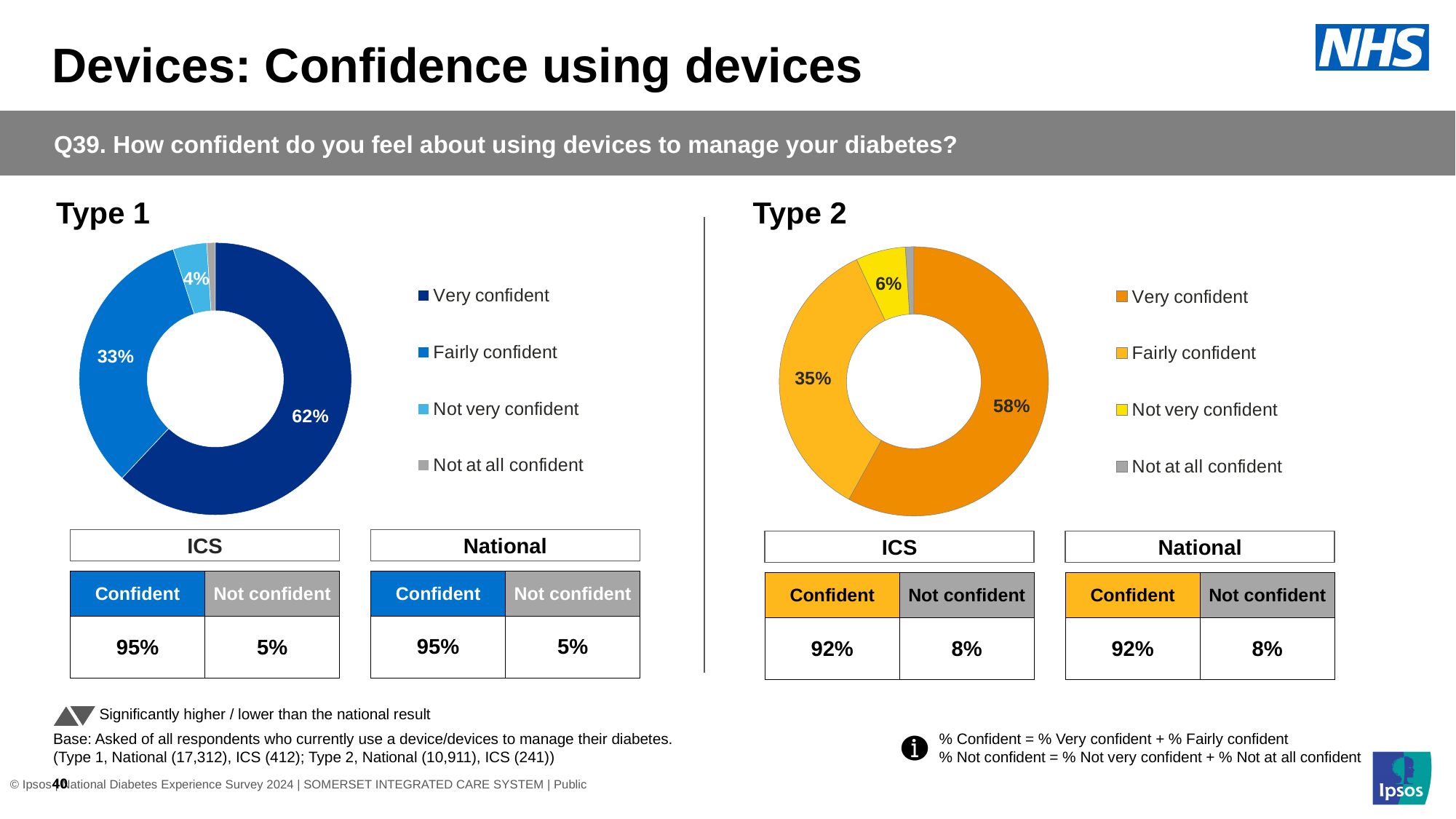
In the Type 1 chart, what percentage are fairly confident? 33% In the Type 2 chart, what percentage are not very confident? 6% In the Type 1 chart, which category has the largest share? Very confident How many categories does the legend of the Type 1 chart list? 4 In the Type 2 chart, which category has the smallest share? Not at all confident In the Type 2 chart, what is the combined share of very confident and fairly confident? 93% Which is larger: the very confident share in the Type 1 chart or the very confident share in the Type 2 chart? Type 1 What kind of chart is used for Type 2? Donut (pie) chart In the Type 2 chart, what colour represents the 'Not very confident' category? Yellow In the Type 2 chart, what percentage are very confident? 58% In the Type 1 chart, what percentage of respondents are very confident using devices? 62% In the Type 1 chart, what is the difference between the very confident and fairly confident shares? 29 percentage points